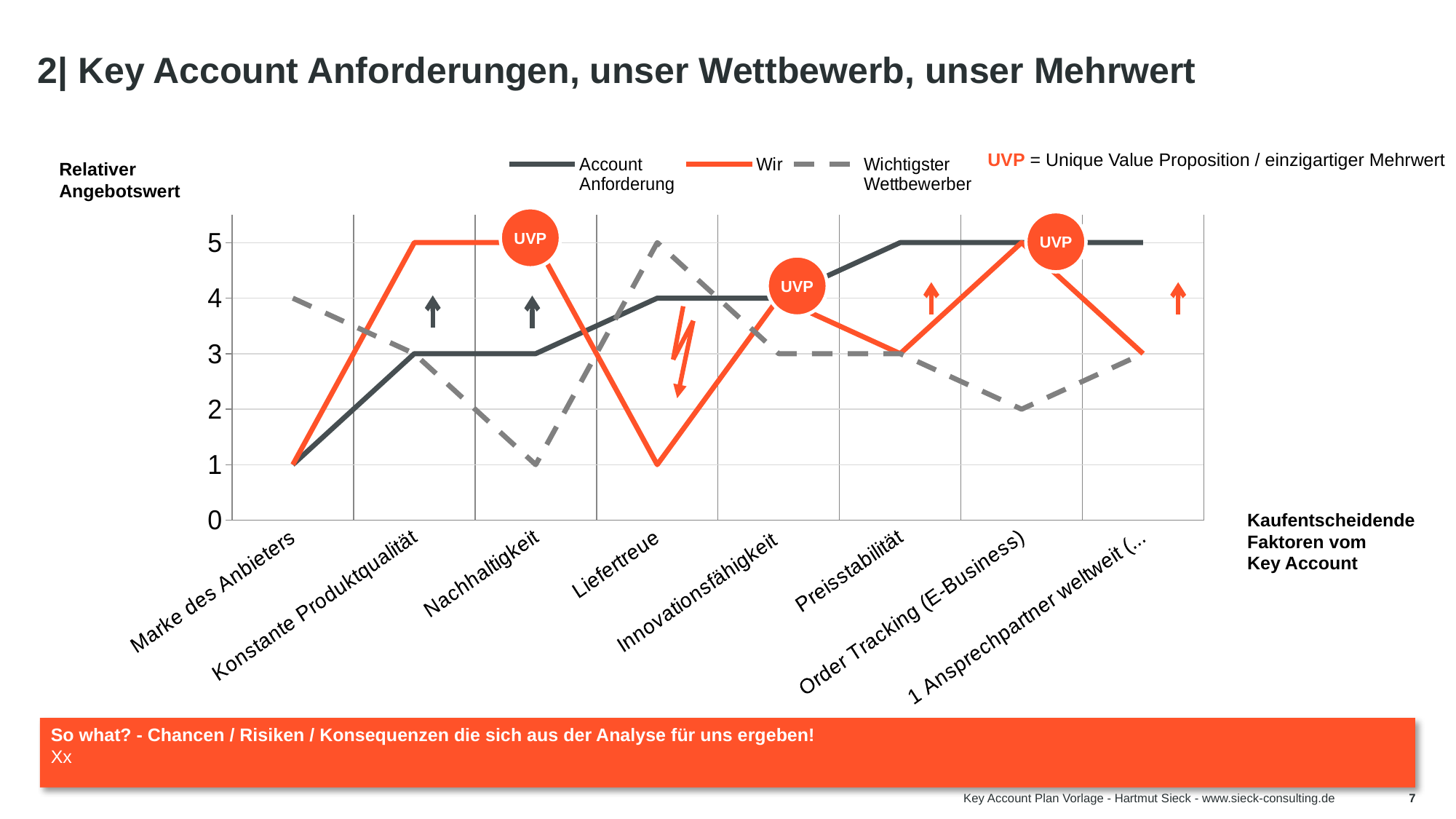
What is the value of the Wichtigster Wettbewerber series for Marke des Anbieters? 4 What is the value of the Wichtigster Wettbewerber series for Order Tracking (E-Business)? 2 Does the Account Anforderung series rise or fall from Marke des Anbieters to Preisstabilität? rise How many series does the legend list? 3 How many categories are shown on the x axis? 8 What kind of chart is shown on the slide? line chart Which series is drawn as a dashed grey line? Wichtigster Wettbewerber What is the value of the Wir series for Liefertreue? 1 What is the value of the Account Anforderung series for Preisstabilität? 5 For which category is the Wichtigster Wettbewerber series lowest? Nachhaltigkeit For Liefertreue, which series has the larger value: Wir or Wichtigster Wettbewerber? Wichtigster Wettbewerber What is the difference between the Wir value and the Account Anforderung value for Konstante Produktqualität? 2